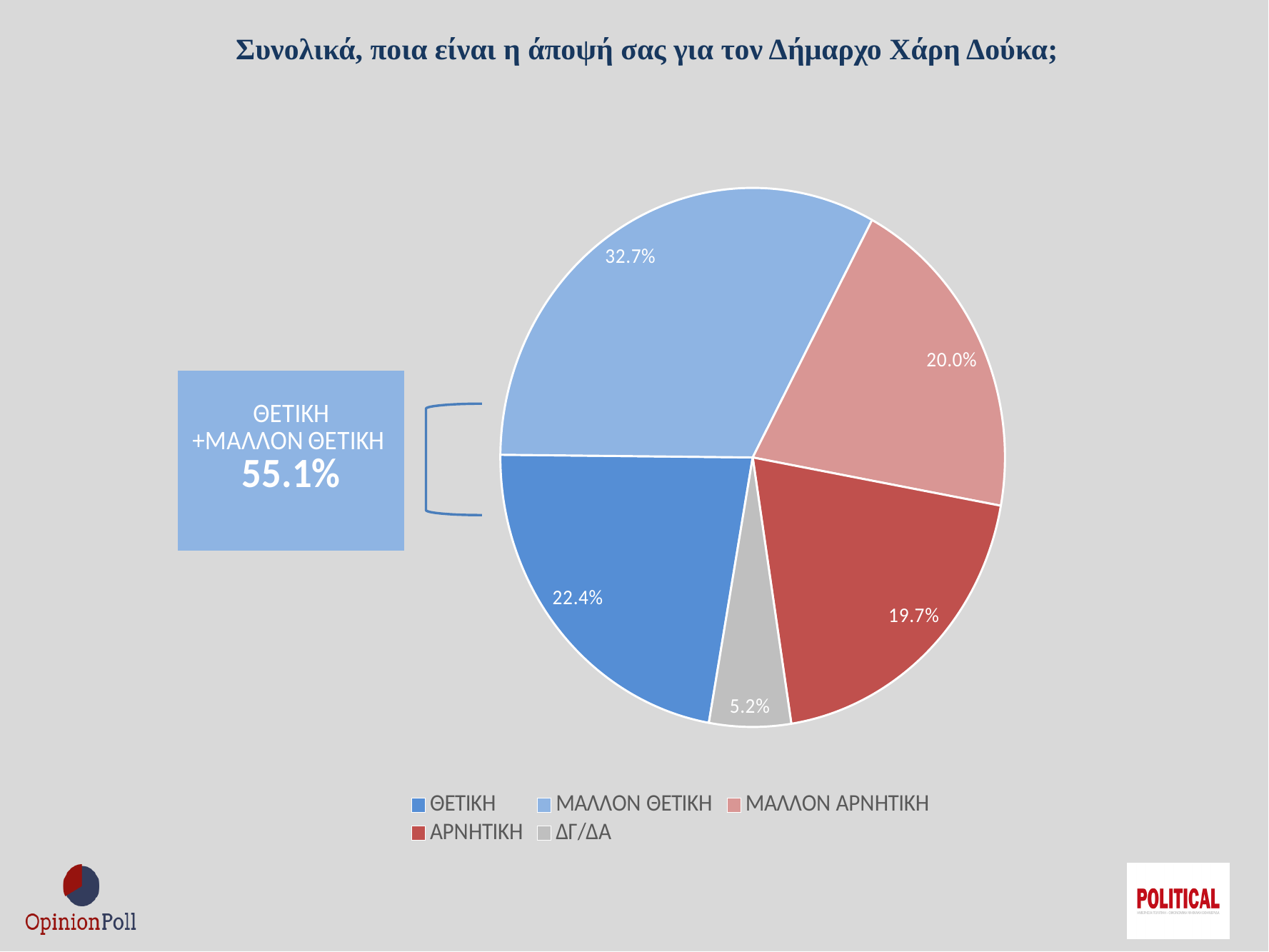
What kind of chart is shown on the slide? pie chart Which category has the smallest share of the pie? ΔΓ/ΔΑ How many categories does the pie chart have? 5 What percentage of respondents answered ΑΡΝΗΤΙΚΗ? 19.7% What percentage of respondents answered ΘΕΤΙΚΗ? 22.4% What combined percentage does the callout box give for ΘΕΤΙΚΗ + ΜΑΛΛΟΝ ΘΕΤΙΚΗ? 55.1% What percentage of respondents answered ΔΓ/ΔΑ? 5.2% What percentage of respondents answered ΜΑΛΛΟΝ ΘΕΤΙΚΗ? 32.7% What is the difference in percentage points between ΜΑΛΛΟΝ ΘΕΤΙΚΗ and ΘΕΤΙΚΗ? 10.3 Which is larger, the share for ΜΑΛΛΟΝ ΘΕΤΙΚΗ or the share for ΜΑΛΛΟΝ ΑΡΝΗΤΙΚΗ? ΜΑΛΛΟΝ ΘΕΤΙΚΗ Which category has the largest share of the pie? ΜΑΛΛΟΝ ΘΕΤΙΚΗ What colour is the ΔΓ/ΔΑ slice in the pie chart? grey